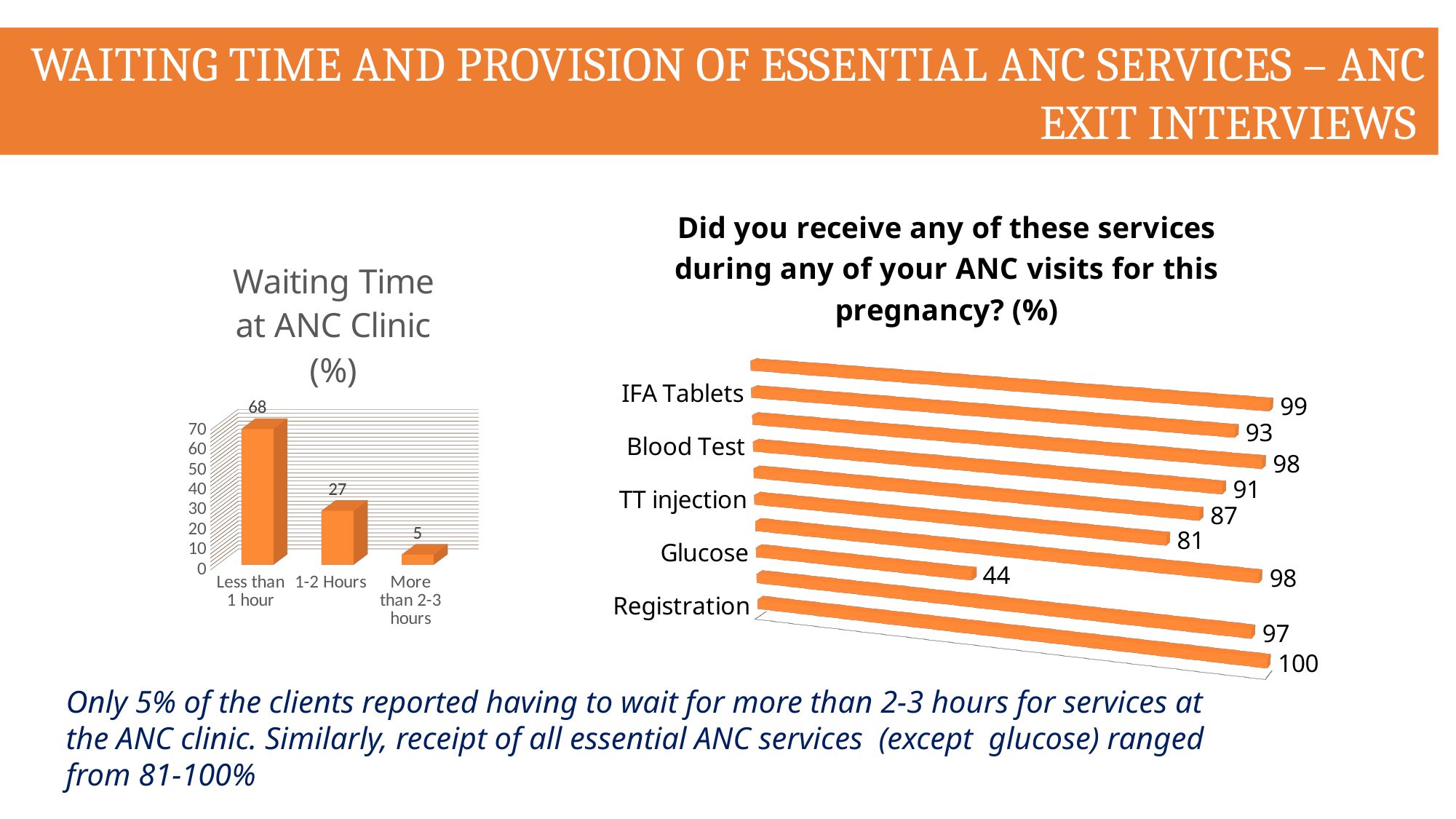
In the Waiting Time at ANC Clinic chart, how many categories are shown? 3 What type of chart is the Waiting Time at ANC Clinic chart? Bar chart In the Waiting Time at ANC Clinic chart, what is the difference between the values for Less than 1 hour and 1-2 Hours? 41 In the chart titled 'Did you receive any of these services during any of your ANC visits for this pregnancy? (%)', how many bars are plotted? 10 In the Waiting Time at ANC Clinic chart, what is the value for 1-2 Hours? 27 In the Waiting Time at ANC Clinic chart, which category has the highest value? Less than 1 hour In the Waiting Time at ANC Clinic chart, do the values rise or fall from left to right? Fall In the chart titled 'Did you receive any of these services during any of your ANC visits for this pregnancy? (%)', what is the highest value shown on any bar? 100 In the Waiting Time at ANC Clinic chart, what percentage of clients waited less than 1 hour? 68 In the Waiting Time at ANC Clinic chart, which category has the lowest value? More than 2-3 hours In the Waiting Time at ANC Clinic chart, what is the value for More than 2-3 hours? 5 In the chart titled 'Did you receive any of these services during any of your ANC visits for this pregnancy? (%)', what is the value for Glucose? 44